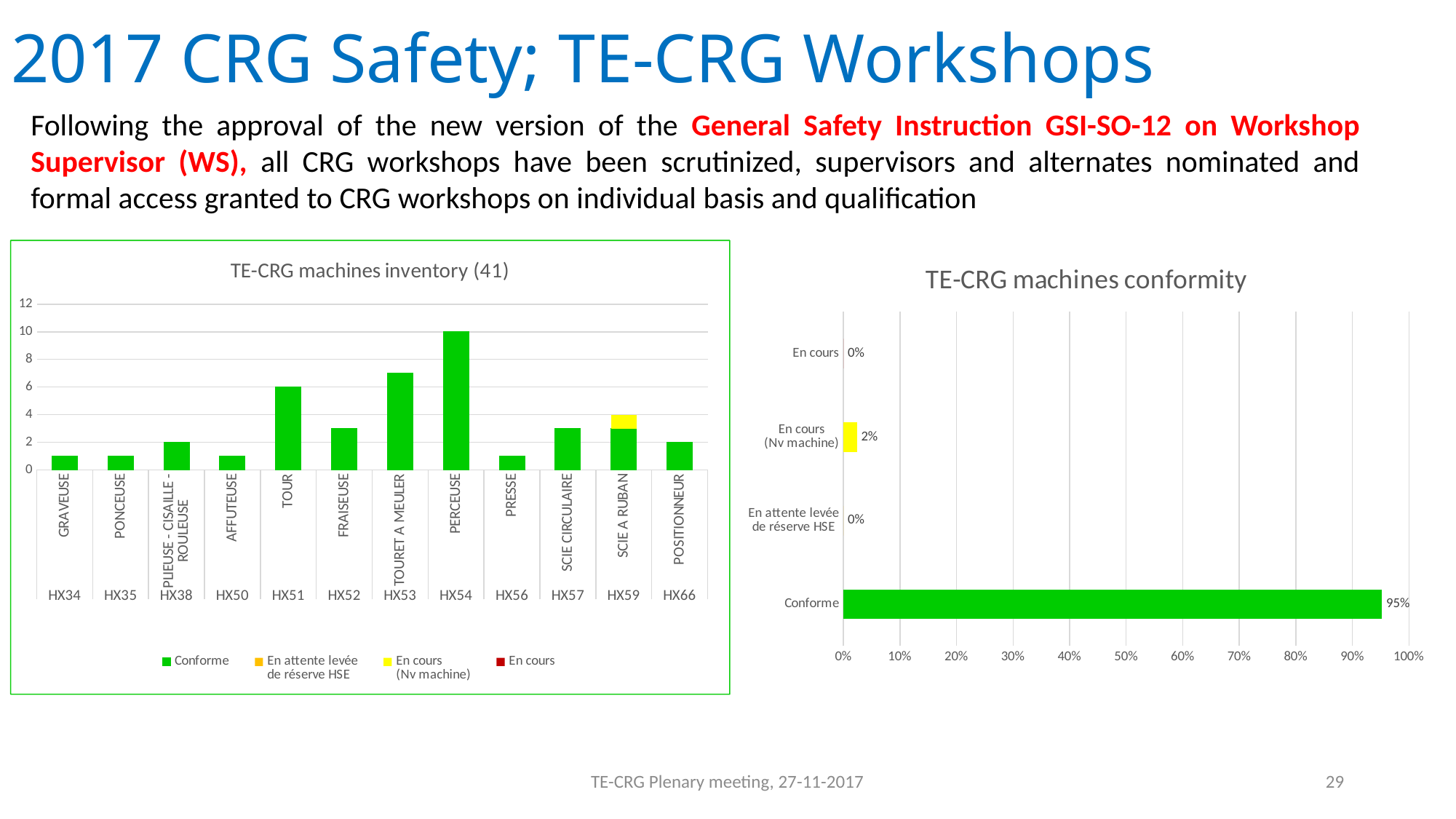
On the TE-CRG machines inventory (41) chart, which machine type has the highest count? PERCEUSE On the TE-CRG machines inventory (41) chart, what is the value for PERCEUSE? 10 What kind of chart is the TE-CRG machines conformity chart? Bar chart On the TE-CRG machines conformity chart, what is the value for En cours (Nv machine)? 2% On the TE-CRG machines inventory (41) chart, how many series does the legend list? 4 On the TE-CRG machines inventory (41) chart, is the value for TOURET A MEULER greater or less than 6? greater On the TE-CRG machines inventory (41) chart, is the value for FRAISEUSE greater or less than 4? less On the TE-CRG machines inventory (41) chart, what is the value for TOUR? 6 On the TE-CRG machines inventory (41) chart, how many machine categories are shown on the x axis? 12 On the TE-CRG machines inventory (41) chart, what is the total of the stacked bar for SCIE A RUBAN? 4 On the TE-CRG machines inventory (41) chart, which is larger, the value for TOUR or the value for POSITIONNEUR? TOUR On the TE-CRG machines conformity chart, what is the value for Conforme? 95%